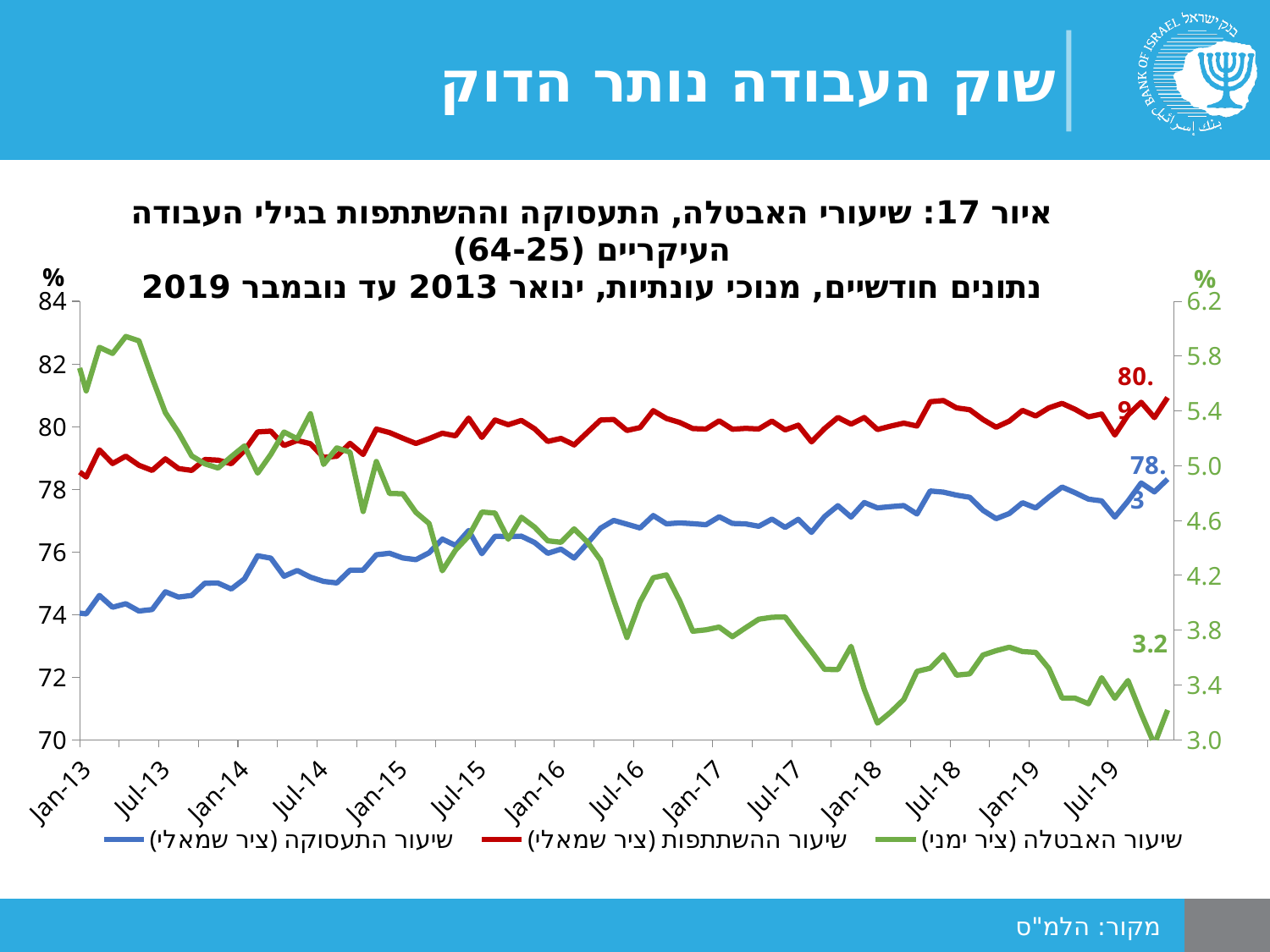
What is the final labelled value of the participation rate series (שיעור ההשתתפות, red line)? 80.9 What is the difference between the final labelled participation rate (80.9) and the final labelled employment rate (78.3)? 2.6 Does the unemployment rate (green line, right axis) rise or fall overall from January 2013 to November 2019? fall What is the final labelled value of the employment rate series (שיעור התעסוקה, blue line)? 78.3 Is the employment rate (blue line) at Jan-13 greater or less than 76 on the left axis? less Is the unemployment rate (green line) at Jan-13 greater or less than 5.4 on the right axis? greater Which series has the higher final labelled value on the left axis: the participation rate (red) or the employment rate (blue)? participation rate (שיעור ההשתתפות) How many series does the legend list? 3 Does the employment rate (blue line) rise or fall overall from January 2013 to November 2019? rise What is the final labelled value of the unemployment rate series (שיעור האבטלה, green line)? 3.2 What type of chart is shown on the slide? line chart Which series is plotted against the right-hand axis (ציר ימני) according to the legend? שיעור האבטלה (unemployment rate)